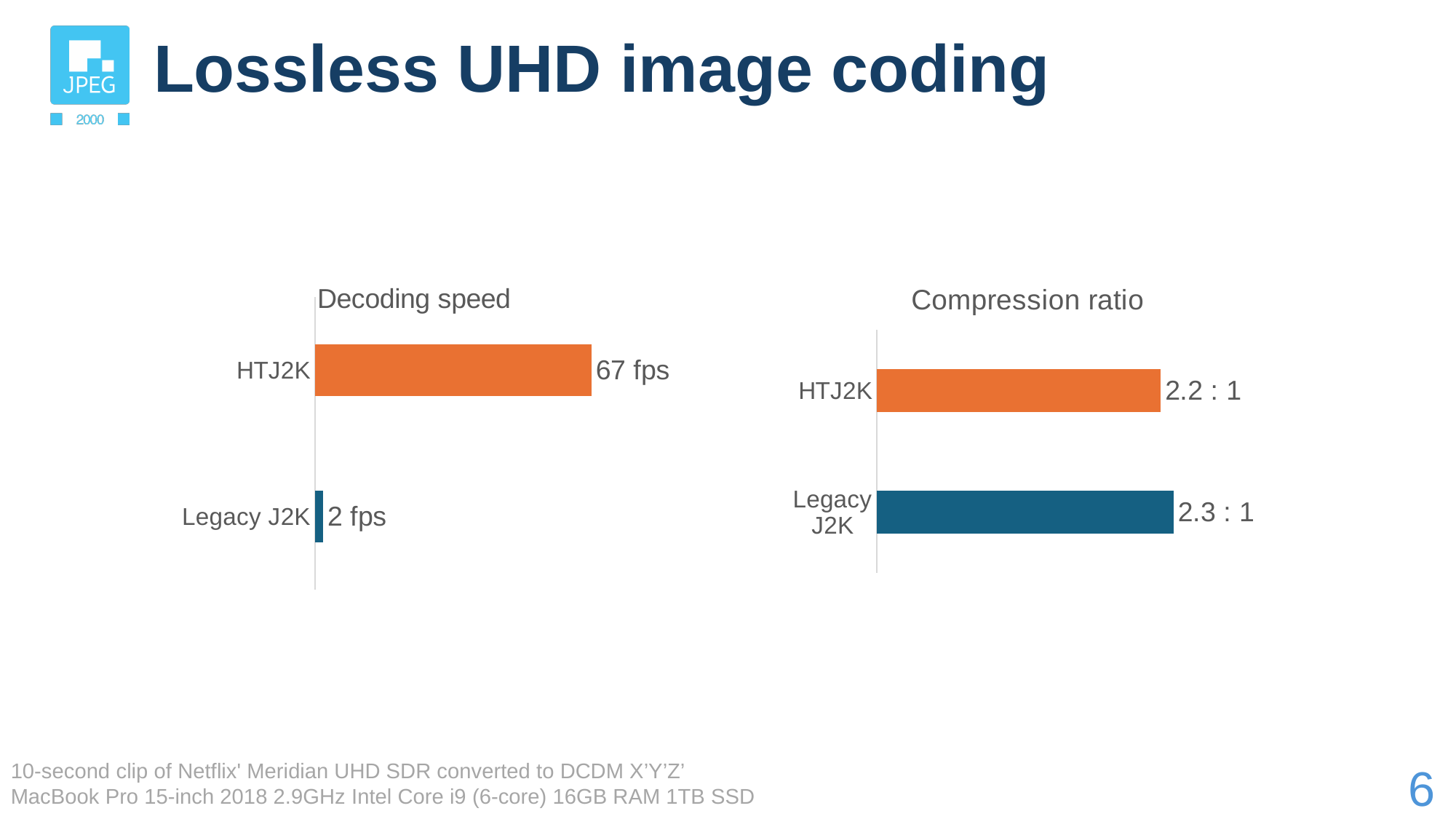
In the Decoding speed chart, what is the difference in fps between HTJ2K and Legacy J2K? 65 fps In the Compression ratio chart, what colour is the bar for Legacy J2K? Blue What kind of chart is the Compression ratio chart? Bar chart In the Decoding speed chart, which category has the highest value? HTJ2K In the Compression ratio chart, which category has the lowest value? HTJ2K In the Decoding speed chart, what is the value for HTJ2K? 67 fps What is the title of the chart on the left of the slide? Decoding speed In the Compression ratio chart, which is larger, the value for HTJ2K or for Legacy J2K? Legacy J2K In the Decoding speed chart, what is the value for Legacy J2K? 2 fps In the Compression ratio chart, what is the value for HTJ2K? 2.2 : 1 How many categories does the Decoding speed chart show? 2 In the Compression ratio chart, what is the value for Legacy J2K? 2.3 : 1